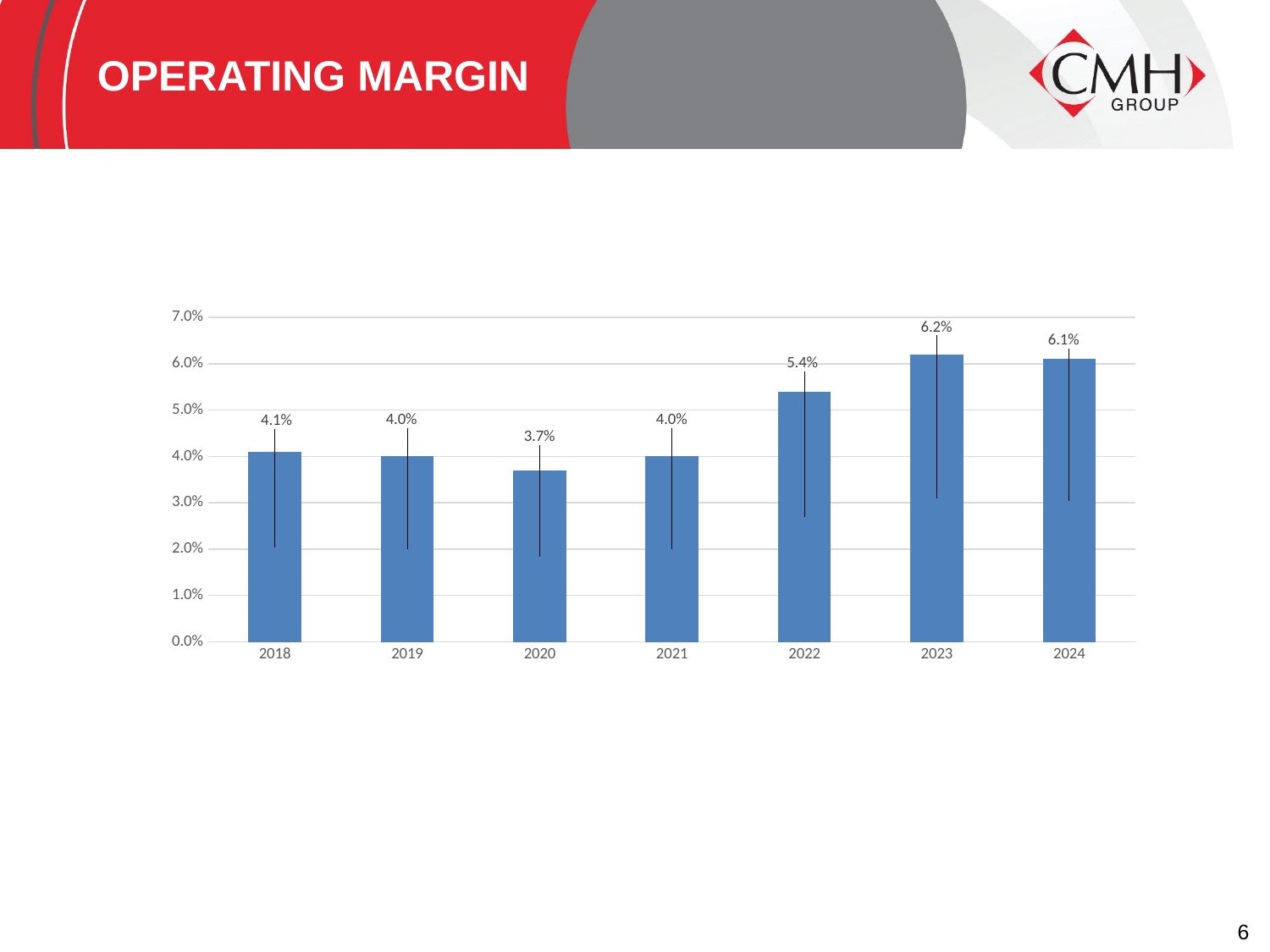
What is the operating margin for 2020? 3.7% Which year has a higher operating margin, 2022 or 2024? 2024 How many years are shown on the chart? 7 What is the difference between the operating margin in 2022 and in 2021? 1.4% What is the operating margin for 2024? 6.1% What is the difference between the operating margin in 2023 and in 2018? 2.1% Is the operating margin for 2023 greater or less than 6.0%? greater What is the title of the slide? OPERATING MARGIN Which year has the highest operating margin? 2023 Which year has the lowest operating margin? 2020 What kind of chart is shown on the slide? Bar chart What is the operating margin for 2022? 5.4%